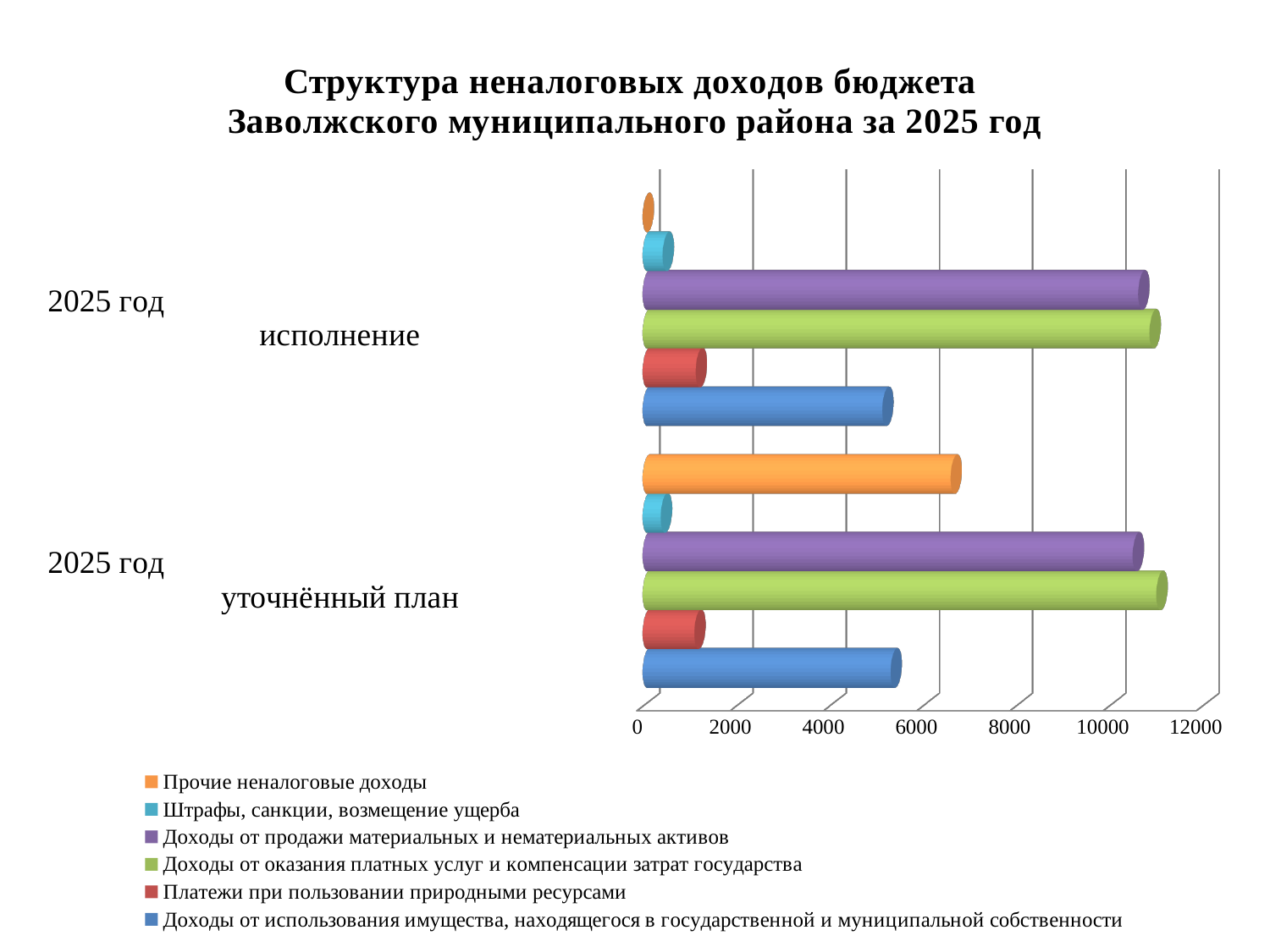
What kind of chart is shown on the slide? bar chart Is the value for Доходы от оказания платных услуг и компенсации затрат государства in 2025 год уточнённый план greater or less than 10000? greater Is the value for Доходы от использования имущества, находящегося в государственной и муниципальной собственности in 2025 год уточнённый план greater or less than 6000? less Is the value for Прочие неналоговые доходы in 2025 год уточнённый план greater or less than 6000? greater Which series has the smallest value in 2025 год уточнённый план? Штрафы, санкции, возмещение ущерба How many categories are shown on the vertical axis? 2 For Прочие неналоговые доходы, which is larger: the value for 2025 год исполнение or for 2025 год уточнённый план? 2025 год уточнённый план Which series has the smallest value in 2025 год исполнение? Прочие неналоговые доходы What colour represents Платежи при пользовании природными ресурсами in the legend? red How many series does the legend list? 6